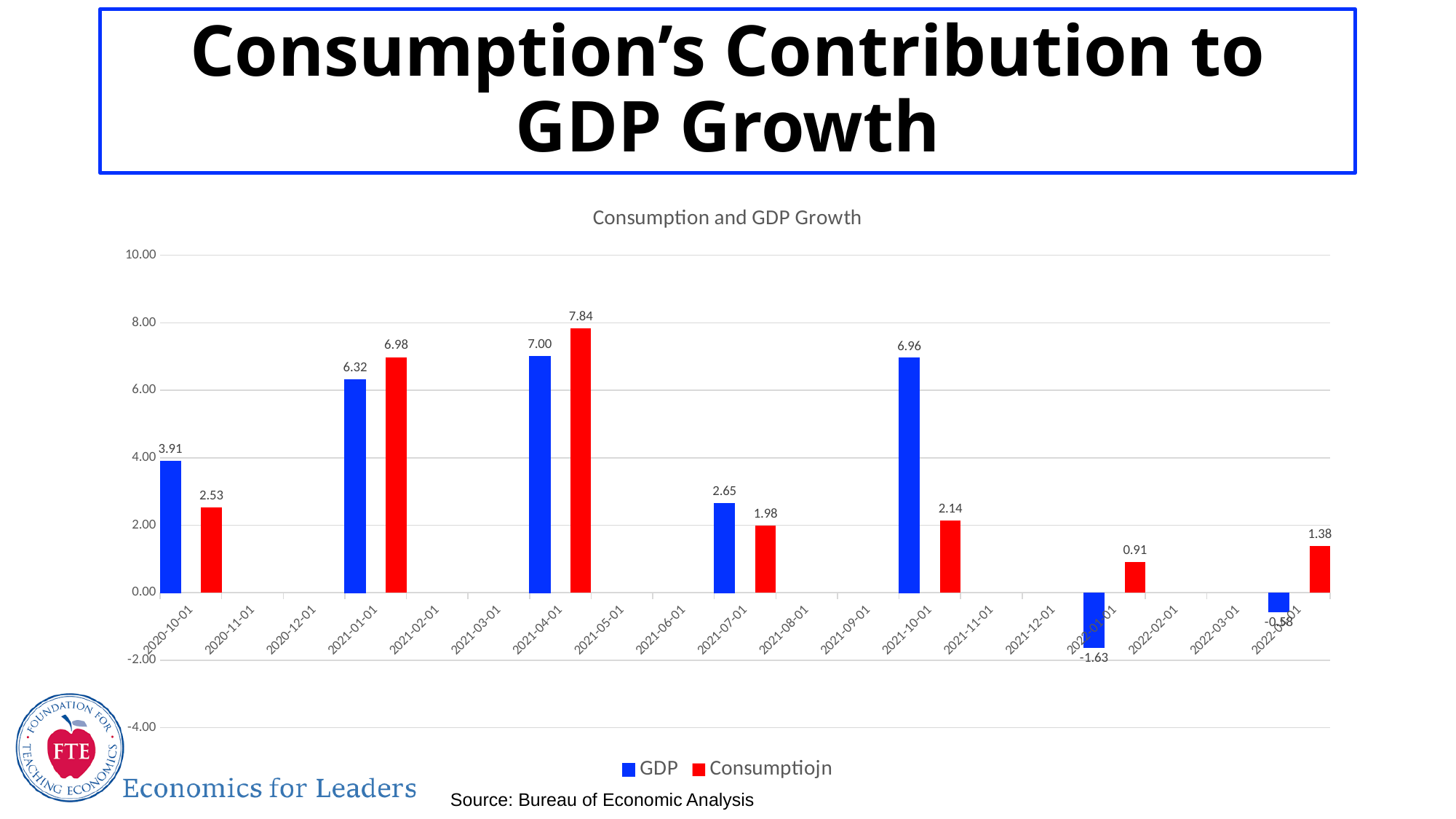
What is the Consumption value for 2021-04-01? 7.84 How many series does the legend list? 2 What is the GDP value for 2022-01-01? -1.63 What kind of chart is shown on the slide? Bar chart What is the Consumption value for 2021-07-01? 1.98 For 2021-10-01, which is larger, GDP or Consumption? GDP What is the difference between the GDP and Consumption values for 2021-10-01? 4.82 What is the GDP value for 2020-10-01? 3.91 Which date has the highest Consumption value? 2021-04-01 What is the difference between the Consumption and GDP values for 2021-01-01? 0.66 What is the title of the chart? Consumption and GDP Growth Which date has the lowest GDP value? 2022-01-01